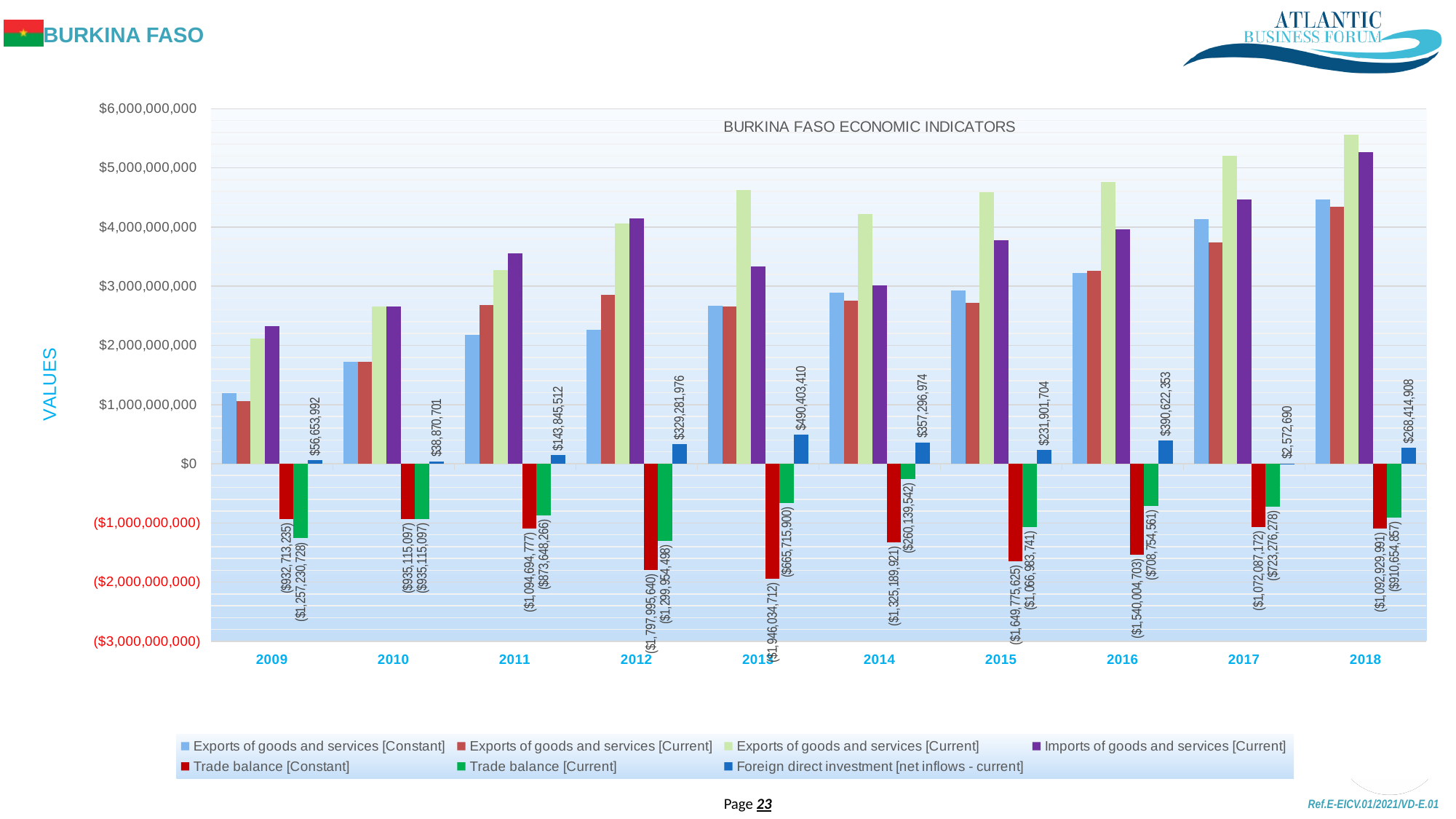
What is the Trade balance [Constant] value for 2012? ($1,797,995,640) How many series does the legend list? 7 In which year is Foreign direct investment [net inflows - current] the lowest? 2017 What is the difference between Foreign direct investment in 2013 and in 2012? $161,121,434 What is the value of Foreign direct investment [net inflows - current] in 2013? $490,403,410 In which year is Foreign direct investment [net inflows - current] the highest? 2013 What is the Trade balance [Current] value for 2014? ($260,139,542) Is the value for Imports of goods and services [Current] in 2018 greater or less than $5,000,000,000? greater Which year has the larger Foreign direct investment value, 2015 or 2016? 2016 What is the title of the chart? BURKINA FASO ECONOMIC INDICATORS How many years are shown on the x axis? 10 What type of chart is shown on the slide? Bar chart